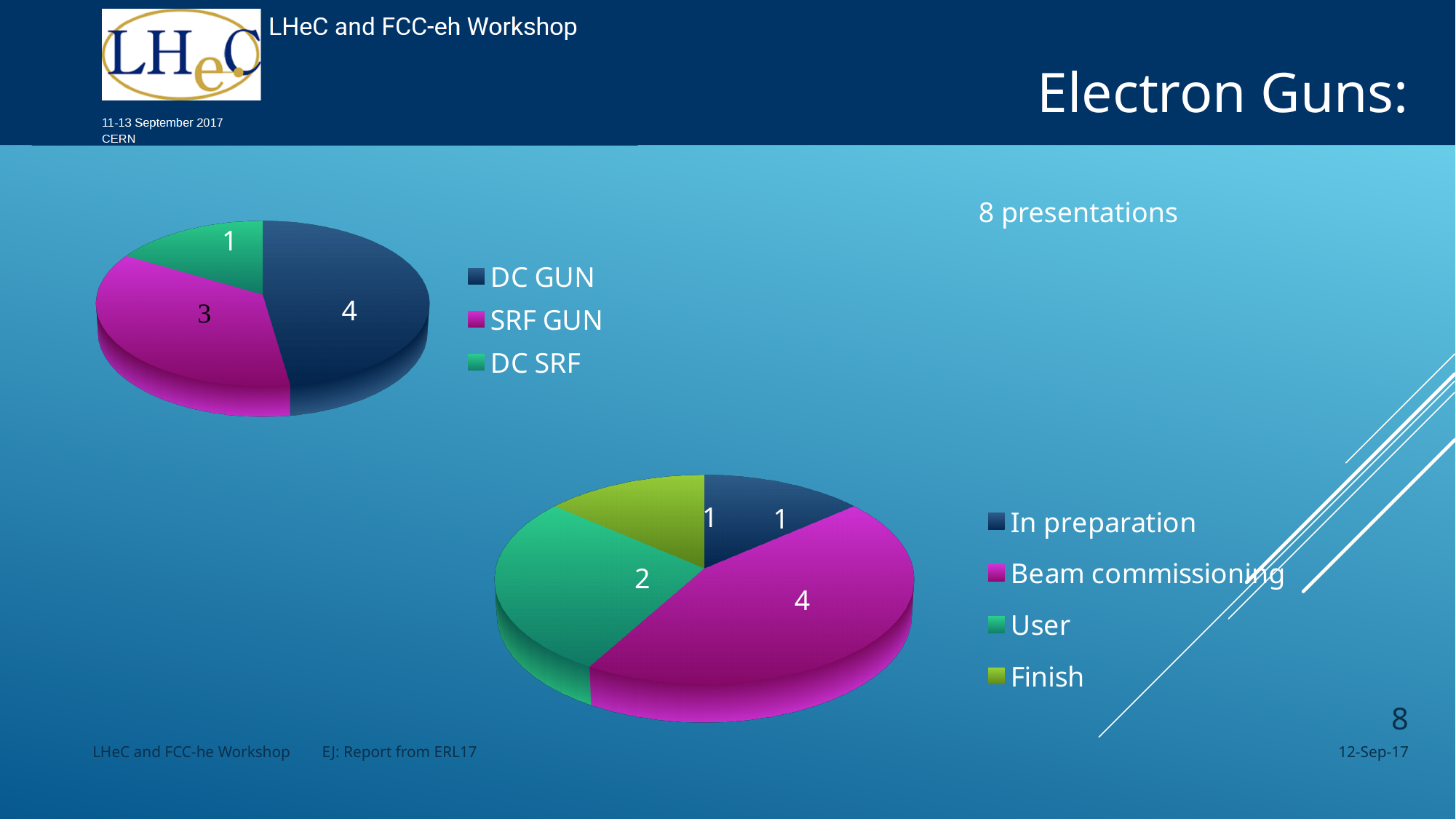
In the top-left pie chart, what is the value for DC GUN? 4 In the bottom-right pie chart, what share of the total does User represent? 25% In the top-left pie chart, what share of the total does DC GUN represent? 50% In the bottom-right pie chart, which category has the largest slice? Beam commissioning What type of chart is the bottom-right chart? Pie chart In the top-left pie chart, what is the difference between the DC GUN and DC SRF values? 3 In the top-left pie chart, which category has the smallest slice? DC SRF In the bottom-right pie chart, what is the value for User? 2 In the top-left pie chart, what is the value for SRF GUN? 3 In the bottom-right pie chart, what is the value for Beam commissioning? 4 In the bottom-right pie chart, which is larger: User or Finish? User How many categories does the top-left pie chart show? 3